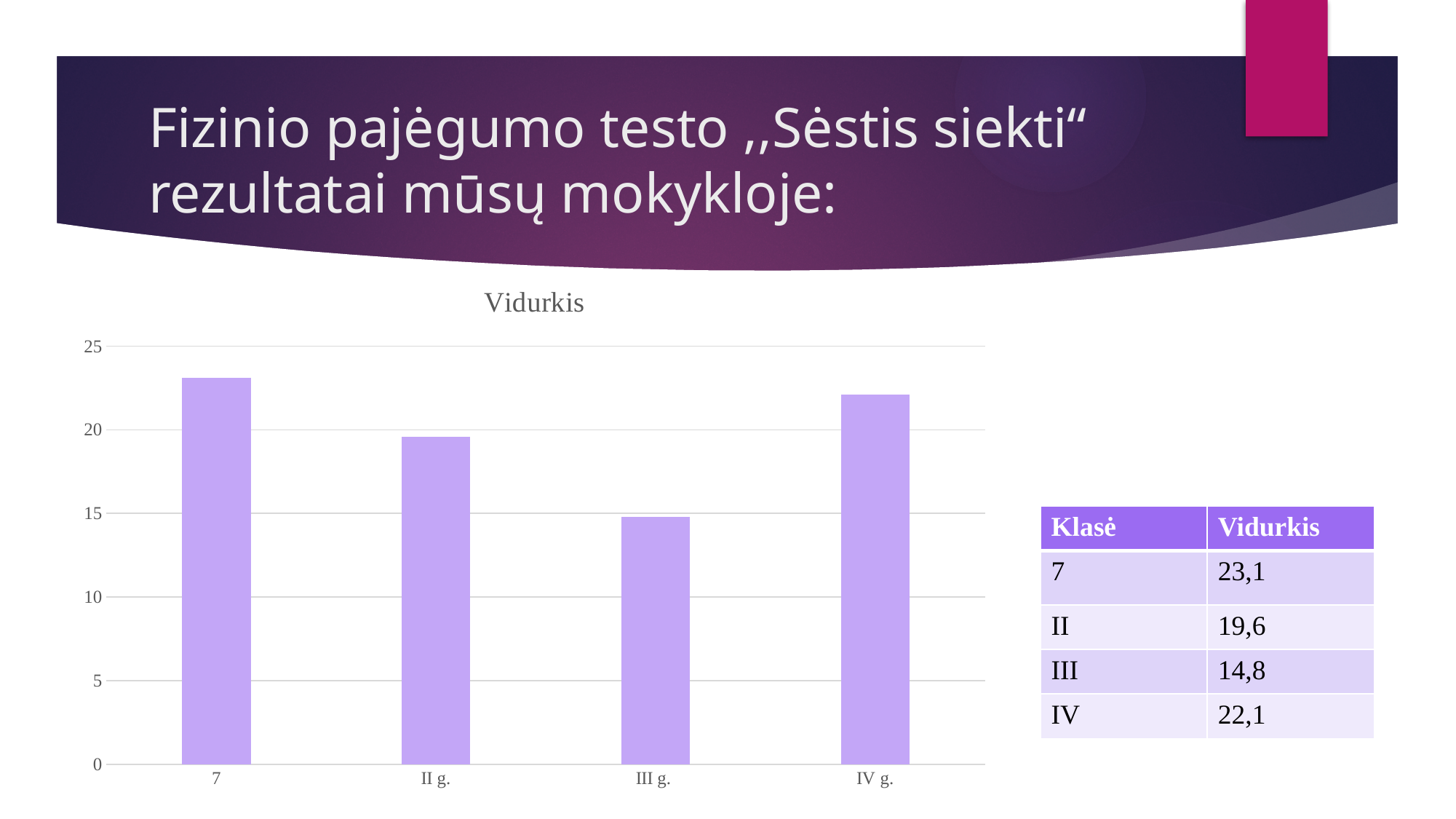
What kind of chart is shown on the slide? bar chart Using the values in the table, what is the difference between the Vidurkis for class 7 and class III? 8,3 Is the value for IV g. greater or less than 20? greater Which is larger, the value for II g. or the value for III g.? II g. According to the table on the slide, what is the Vidurkis value for class III? 14,8 Is the value for II g. greater or less than 15? greater How many categories are shown on the x axis of the chart? 4 What is the title of the chart? Vidurkis According to the table on the slide, what is the Vidurkis value for class 7? 23,1 Is the value for III g. greater or less than 15? less Which category has the highest value in the chart? 7 Which category has the lowest value in the chart? III g.